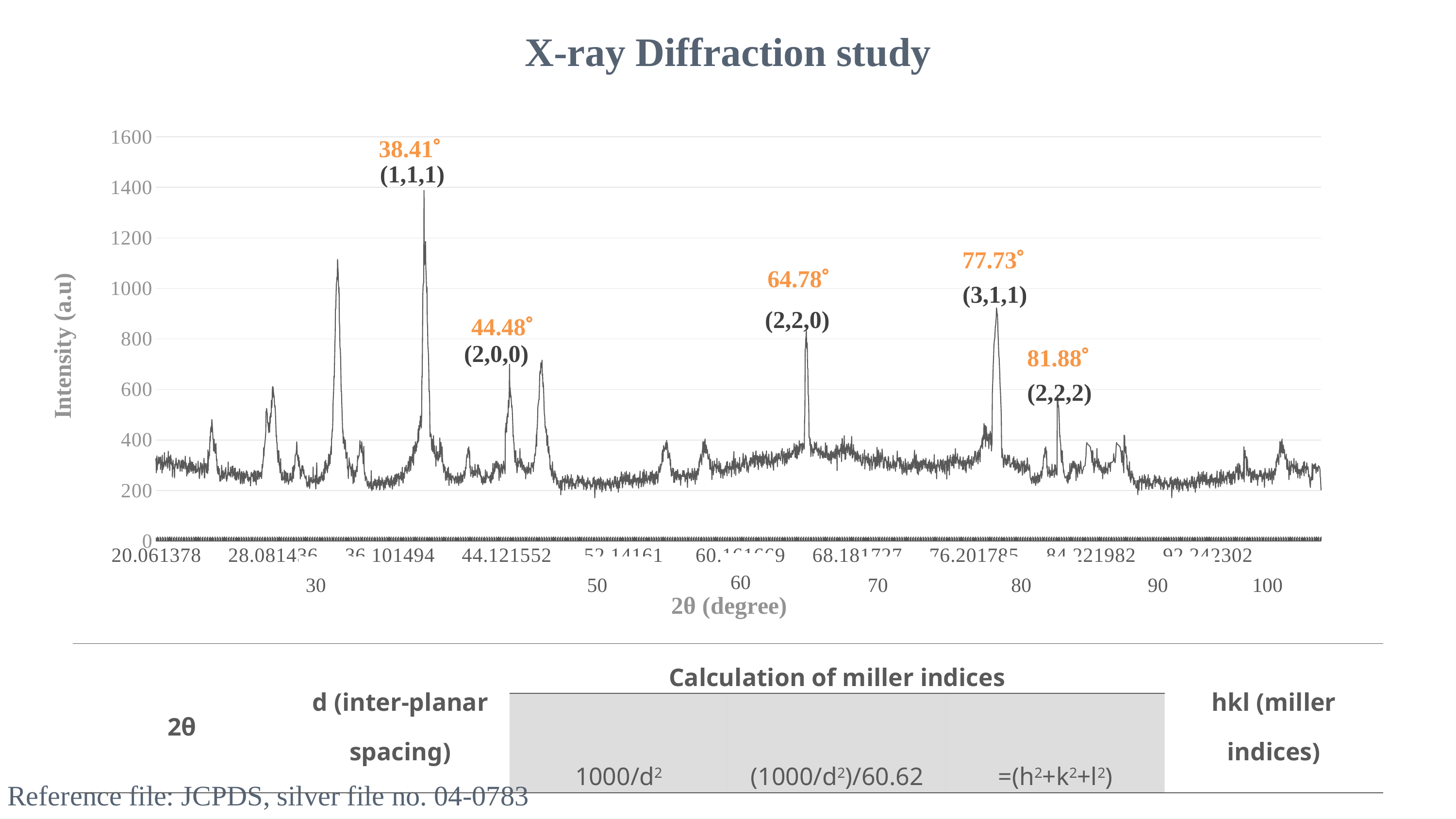
How many peaks are labelled with 2θ angles and Miller indices on the chart? 5 Which labelled peak has the lowest intensity? 81.88° (2,2,2) Is the intensity of the peak at 64.78° greater or less than 1000? less What Miller indices are assigned to the peak at 44.48°? (2,0,0) Which peak has a higher intensity, the one at 77.73° or the one at 81.88°? 77.73° Which labelled peak has the highest intensity? 38.41° (1,1,1) What kind of chart is shown on the slide? line chart What is the label of the y axis? Intensity (a.u) At what 2θ angle is the (2,2,0) peak labelled? 64.78° At what 2θ angle is the (3,1,1) peak labelled? 77.73° What is the title of the chart? X-ray Diffraction study Is the intensity of the peak at 38.41° greater or less than 1200? greater